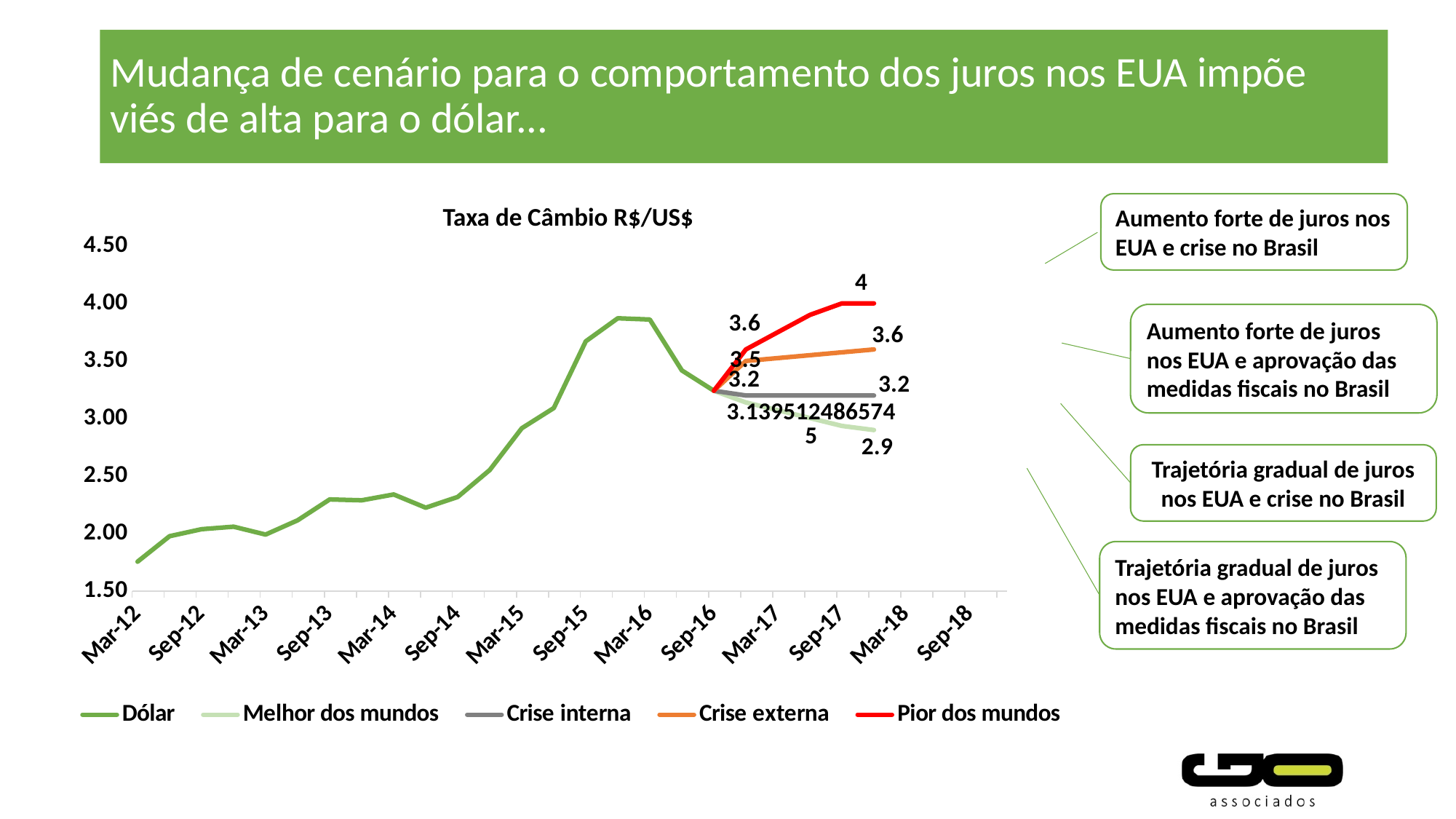
How many series does the legend of the chart list? 5 What is the title of the chart? Taxa de Câmbio R$/US$ Is the value of the Dólar series at Mar-12 greater or less than 2.00? less What kind of chart is shown on the slide? line chart